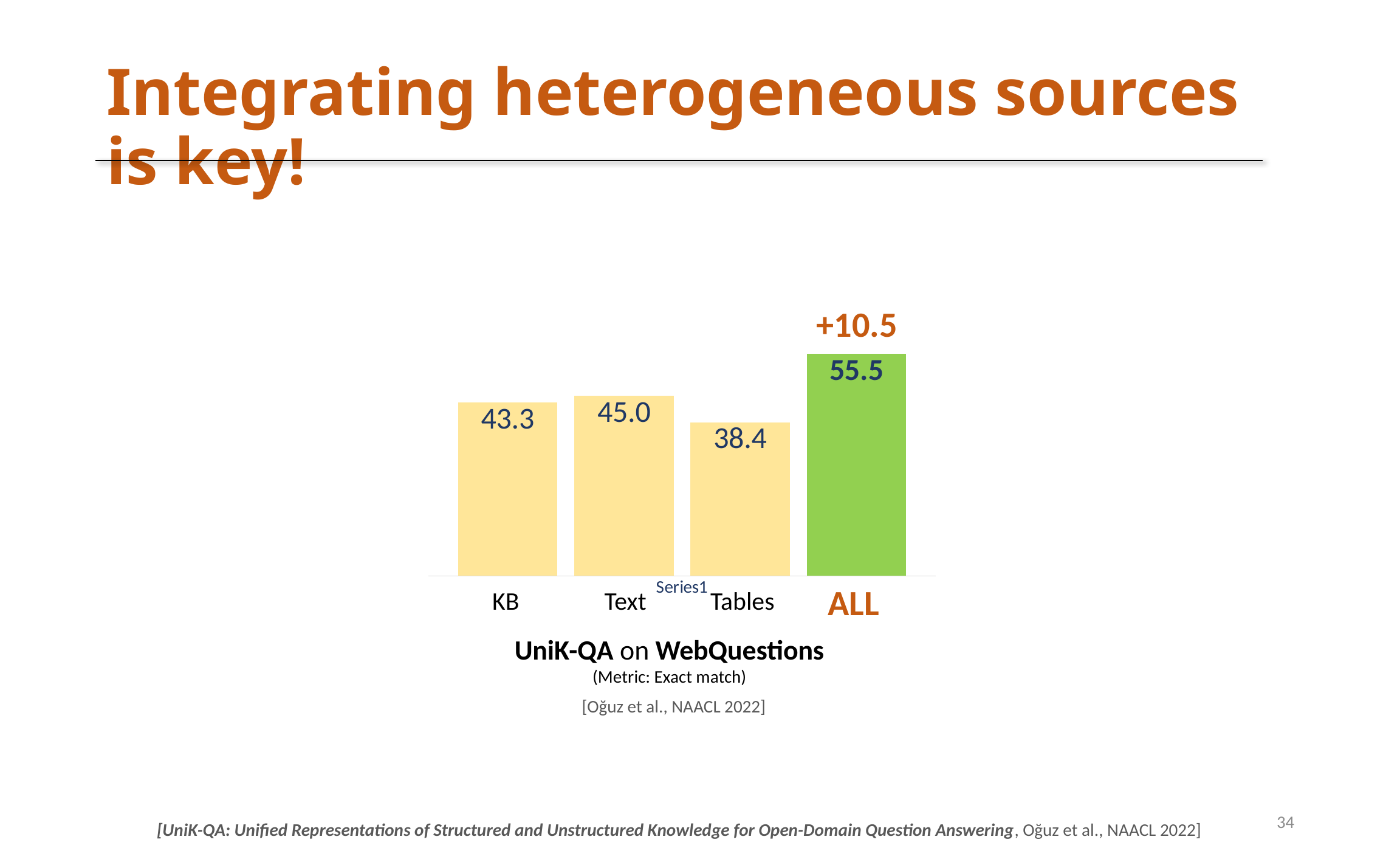
Which category has the lowest value? Tables What is the difference between the values for KB and Tables? 4.9 Which is larger, the value for KB or the value for Text? Text What is the value for KB? 43.3 What kind of chart is shown on the slide? bar chart What is the value for Text? 45.0 What is the value for Tables? 38.4 What is the value for ALL? 55.5 How many categories are shown on the x axis? 4 Which category has the highest value? ALL What metric is the chart reported in, according to the caption below it? Exact match What is the difference between the values for ALL and Text? 10.5